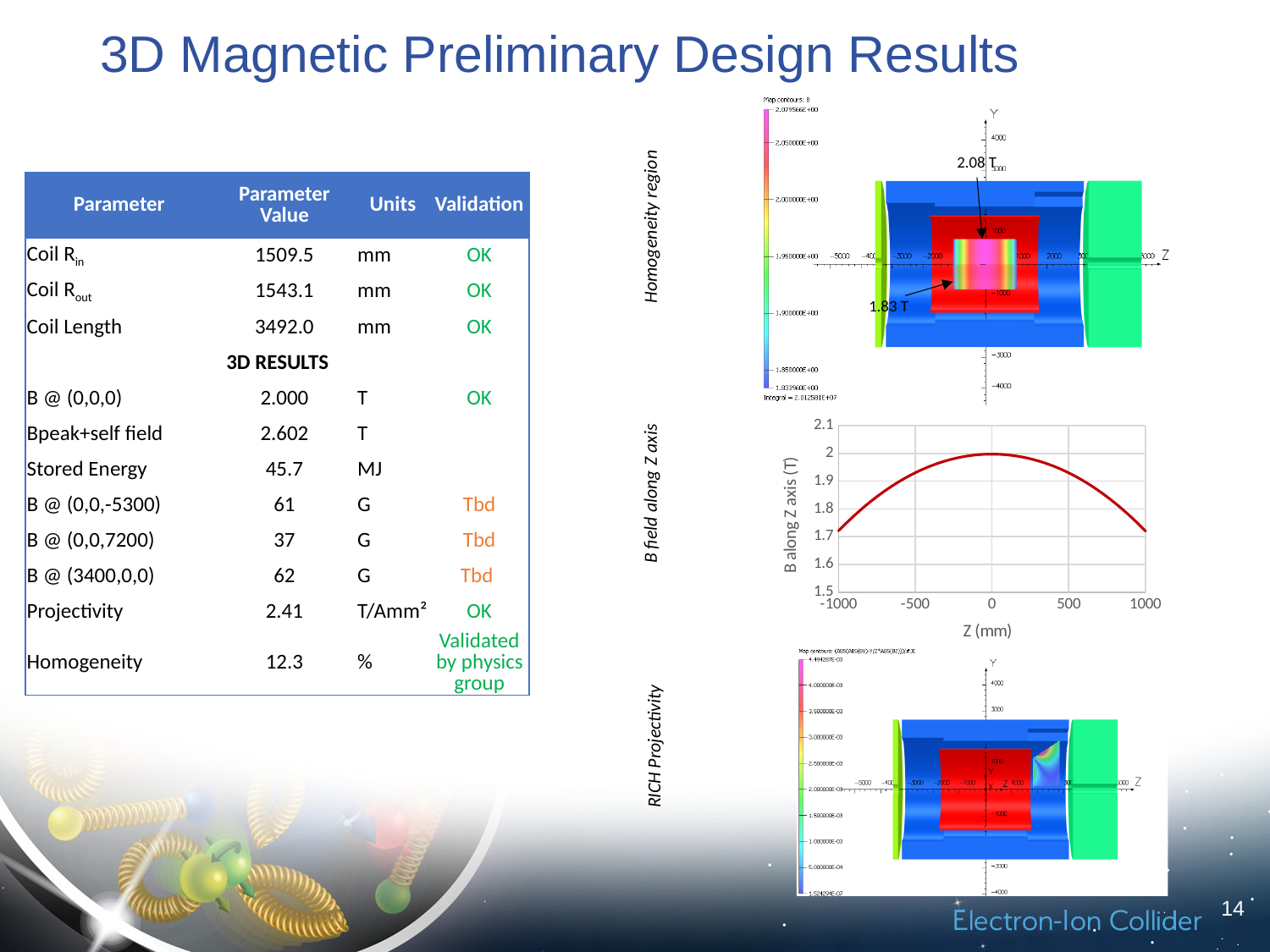
In the 'B field along Z axis' chart, is the value at Z = 1000 greater or less than 1.8? less What is the x-axis label of the 'B field along Z axis' chart? Z (mm) In the 'B field along Z axis' chart, is the value at Z = -1000 greater or less than 1.7? greater In the 'B field along Z axis' chart, is the value at Z = -500 greater or less than 1.9? greater In the 'Homogeneity region' field map, what is the higher of the two annotated field values? 2.08 T In the 'B field along Z axis' chart, does the curve rise or fall as Z goes from 0 to 1000? fall In the 'B field along Z axis' chart, at which Z value does the curve reach its maximum? 0 In the 'B field along Z axis' chart, does the curve rise or fall as Z goes from -1000 to 0? rise In the 'B field along Z axis' chart, which is larger: the value at Z = 0 or the value at Z = 500? Z = 0 How many lines are plotted in the 'B field along Z axis' chart? 1 What kind of chart is the 'B field along Z axis' plot? line chart